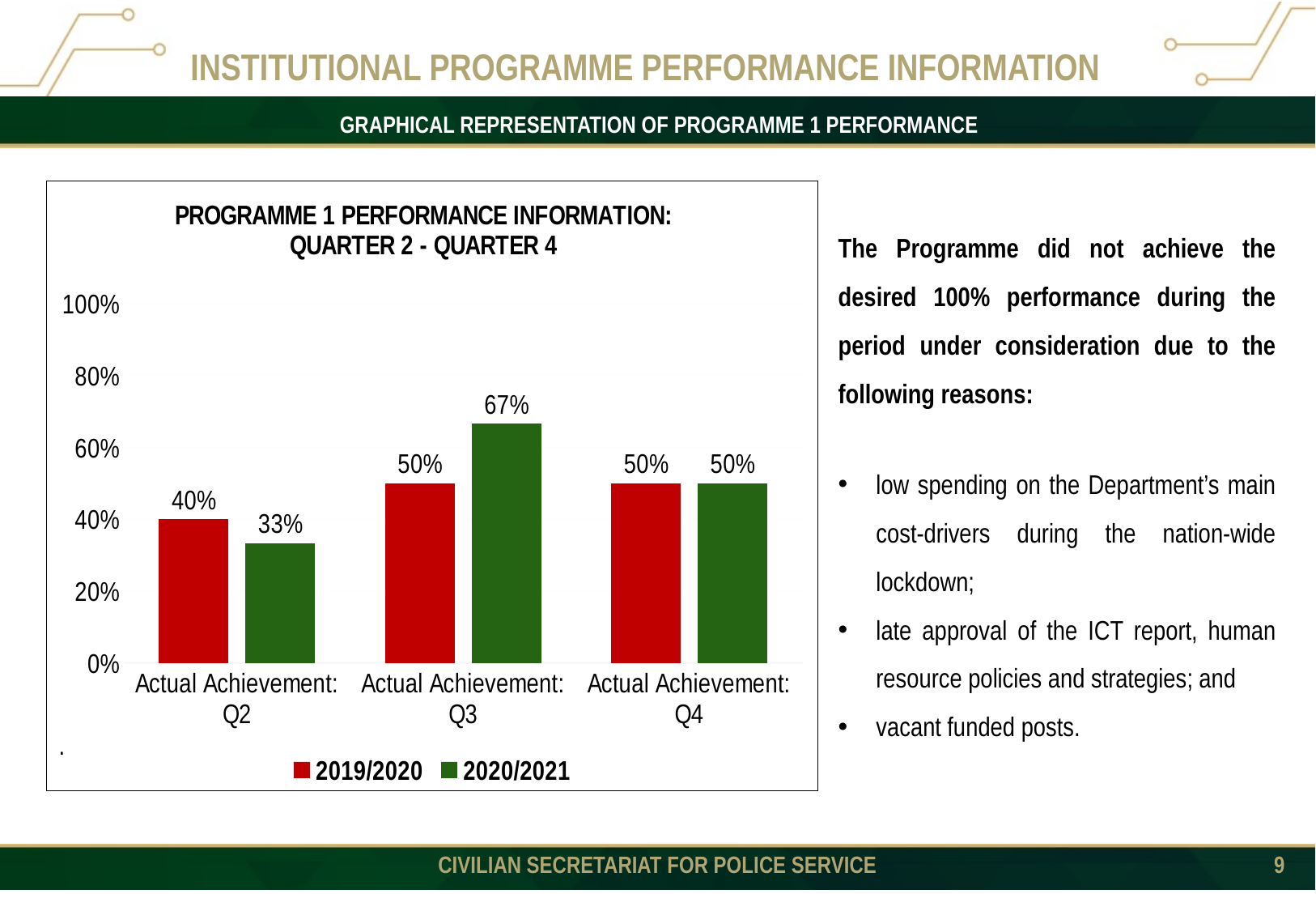
What is the 2020/2021 value for Actual Achievement: Q3? 67% How many quarter categories are shown on the x axis? 3 What is the title of the chart? PROGRAMME 1 PERFORMANCE INFORMATION: QUARTER 2 - QUARTER 4 What is the difference between the 2020/2021 and 2019/2020 values for Actual Achievement: Q3? 17% For Actual Achievement: Q2, which series has the larger value, 2019/2020 or 2020/2021? 2019/2020 How many series does the legend list? 2 Which quarter has the lowest 2019/2020 value? Actual Achievement: Q2 Is the 2020/2021 value for Actual Achievement: Q3 greater or less than 60%? greater What is the 2020/2021 value for Actual Achievement: Q2? 33% What is the 2019/2020 value for Actual Achievement: Q2? 40% Which quarter has the highest 2020/2021 value? Actual Achievement: Q3 What kind of chart is shown on the slide? Bar chart